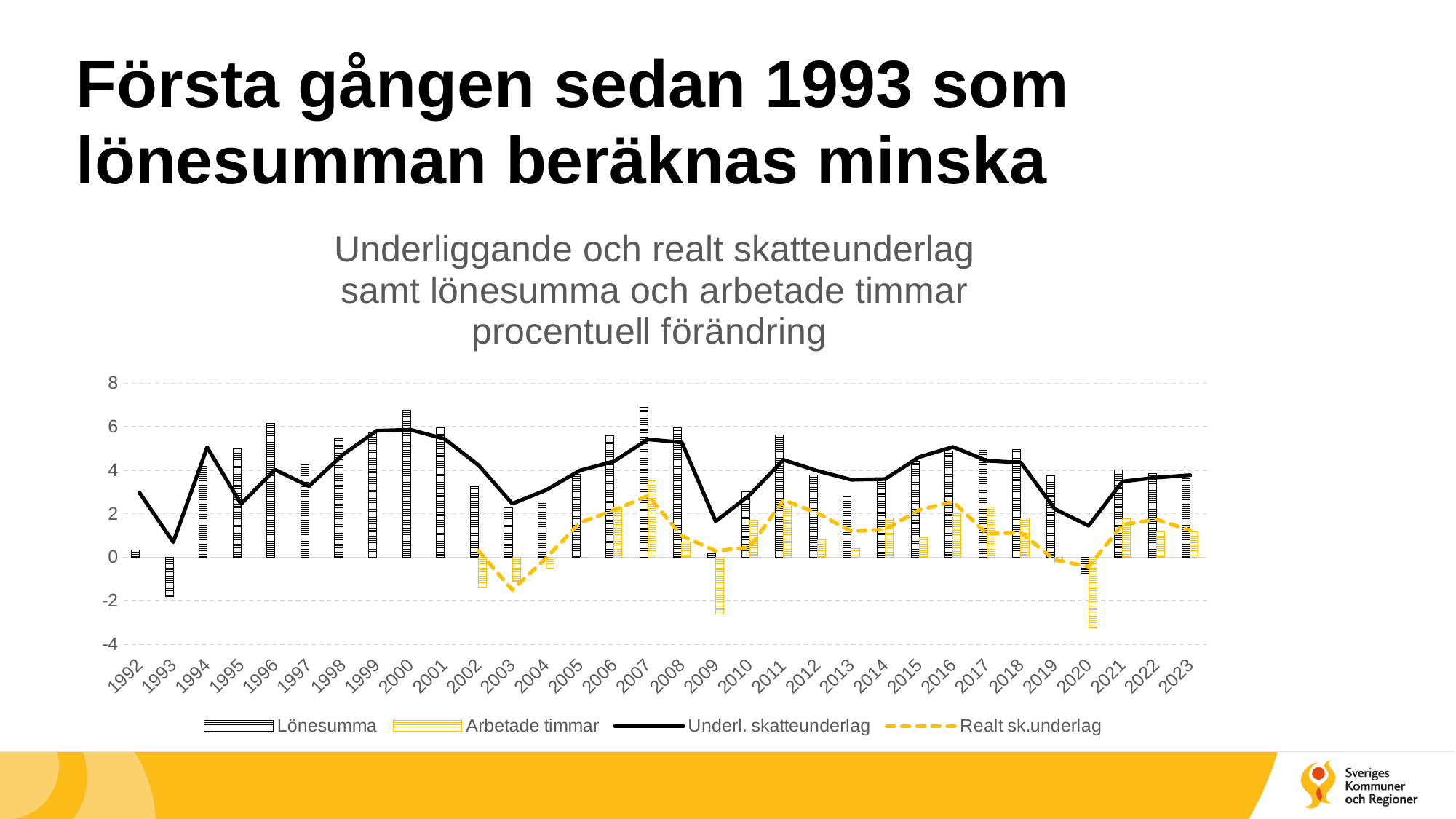
Does the Underl. skatteunderlag line rise or fall from 2018 to 2020? Fall What kind of chart is shown on the slide? A combined bar and line chart Which year has the lowest value for Arbetade timmar? 2020 How many years are shown on the x axis? 32 Is the value for Arbetade timmar in 2020 greater or less than -2? less Which series is drawn as a dashed yellow line? Realt sk.underlag What is the first line of the chart's title? Underliggande och realt skatteunderlag Which year has the lowest value for Lönesumma? 1993 How many series does the legend list? 4 Which is larger, the Lönesumma value for 1996 or for 1997? 1996 Is the value for Underl. skatteunderlag in 2009 greater or less than 2? less Is the value for Lönesumma in 2000 greater or less than 6? greater